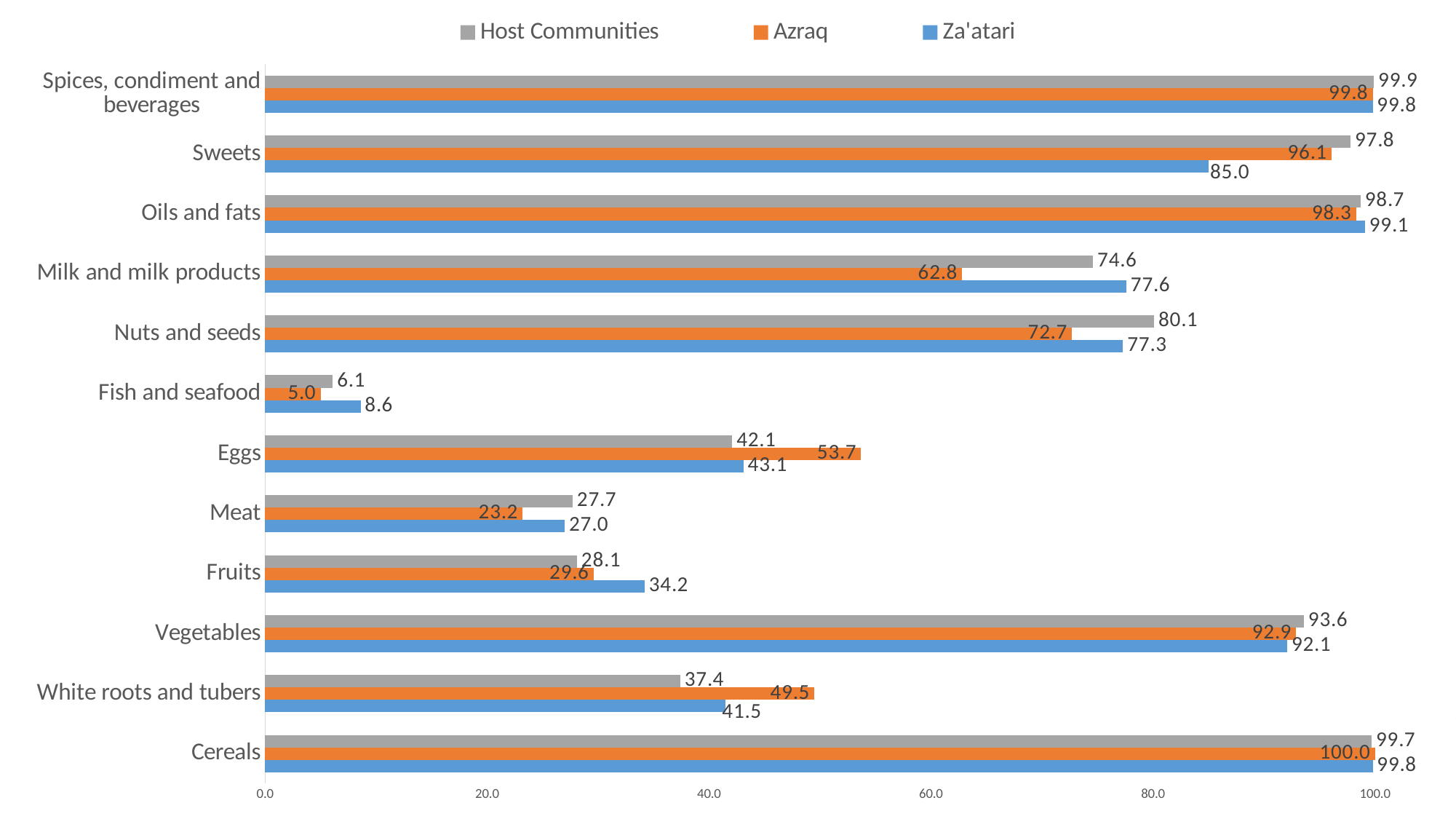
How many series does the legend list? 3 What is the value for Za'atari in the Sweets category? 85.0 What kind of chart is shown on the slide? Bar chart Is the value for Za'atari in the Nuts and seeds category greater or less than 80.0? less What is the difference between the Host Communities and Azraq values for Milk and milk products? 11.8 Which colour represents Azraq in the chart? Orange How many food categories are shown on the chart? 12 Which is larger for White roots and tubers: the Azraq value or the Host Communities value? Azraq Which category has the lowest value for Za'atari? Fish and seafood What is the value for Host Communities in the Milk and milk products category? 74.6 What is the value for Azraq in the Eggs category? 53.7 Which category has the highest value for Azraq? Cereals